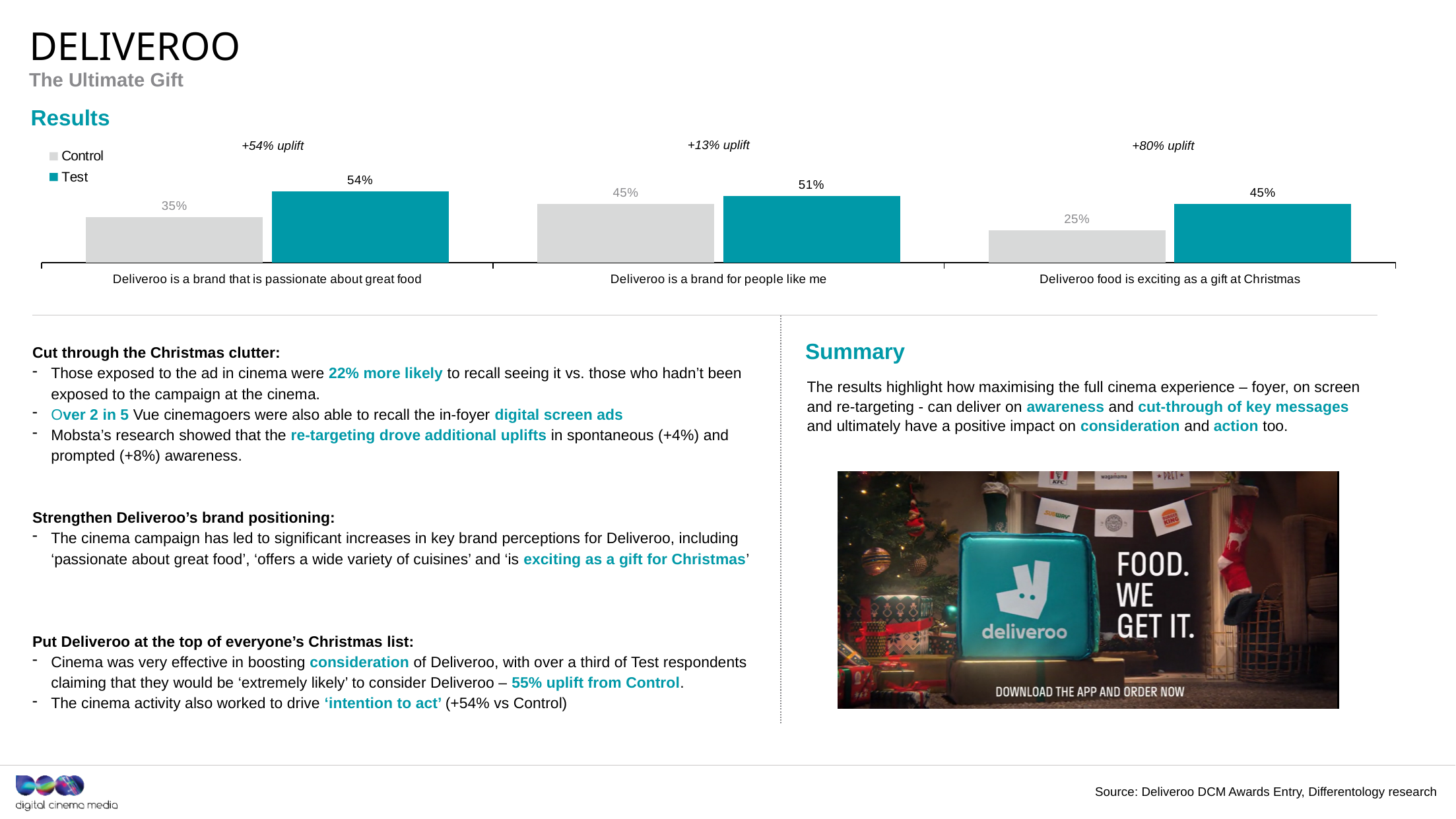
What is the Control value for 'Deliveroo is a brand for people like me'? 45% What is the Test value for 'Deliveroo food is exciting as a gift at Christmas'? 45% What is the Test value for 'Deliveroo is a brand that is passionate about great food'? 54% Which category has the lowest Control value? Deliveroo food is exciting as a gift at Christmas How many series does the chart legend list? 2 What is the difference between the Test and Control values for 'Deliveroo food is exciting as a gift at Christmas'? 20 percentage points How many categories are shown on the x axis of the chart? 3 Which category has the highest Test value? Deliveroo is a brand that is passionate about great food What uplift is annotated above the 'Deliveroo is a brand for people like me' bars? +13% uplift Which is larger for 'Deliveroo is a brand for people like me': the Control value or the Test value? Test What kind of chart is shown on the slide? Bar chart What is the Control value for 'Deliveroo food is exciting as a gift at Christmas'? 25%